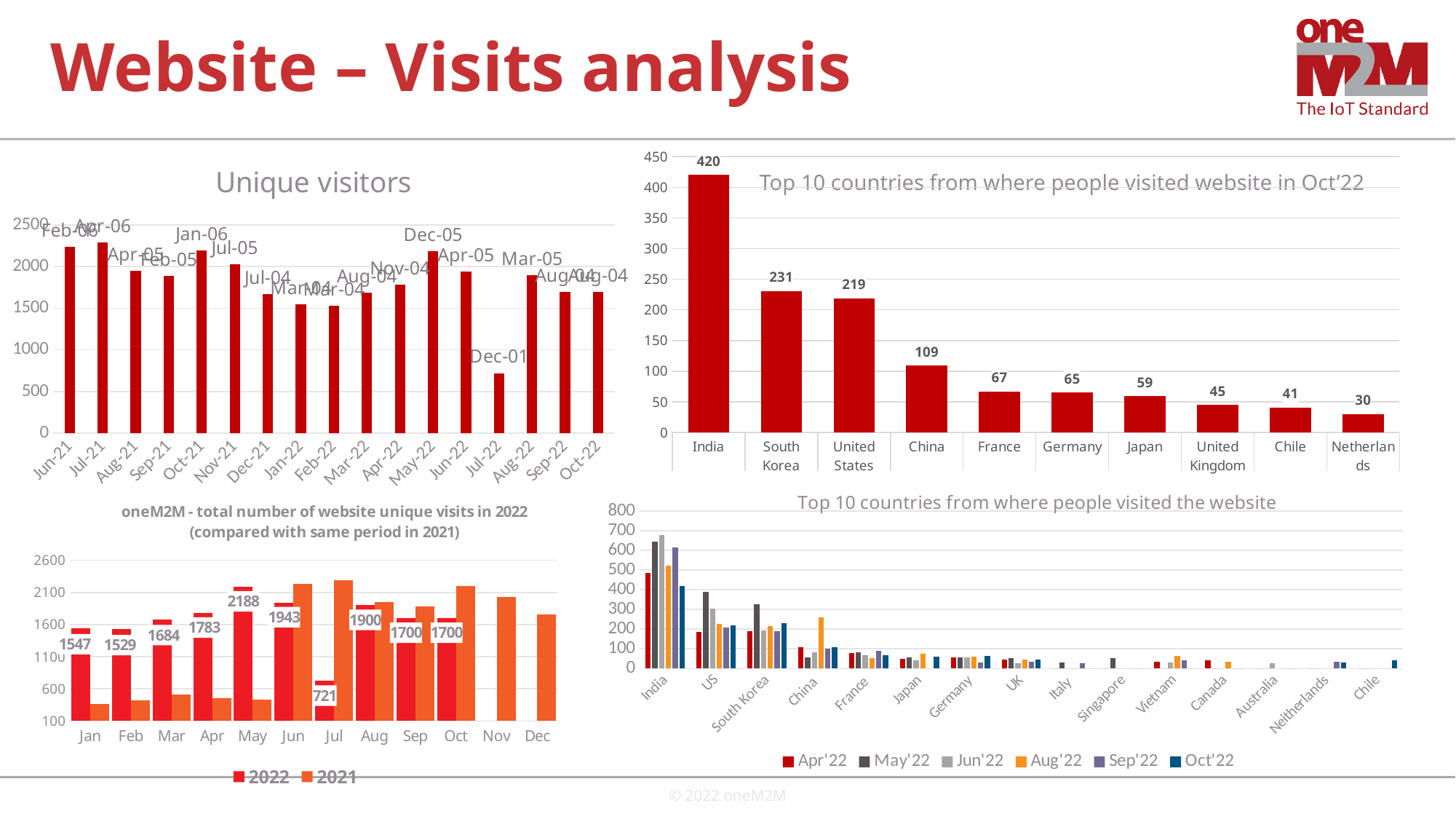
In the chart 'Top 10 countries from where people visited website in Oct'22', how many countries are shown? 10 In the bottom-left chart 'oneM2M - total number of website unique visits in 2022', what is the 2022 value for May? 2188 In the chart 'Top 10 countries from where people visited website in Oct'22', which country has the lowest value? Netherlands In the chart 'Top 10 countries from where people visited website in Oct'22', what is the value for India? 420 In the chart 'Top 10 countries from where people visited website in Oct'22', what is the difference between South Korea and United States? 12 In the 'Unique visitors' chart, is the value for Jul-22 greater or less than 1000? less In the bottom-left chart 'oneM2M - total number of website unique visits in 2022', how many series does the legend list? 2 What kind of chart is the 'Unique visitors' chart? bar chart In the bottom-right chart 'Top 10 countries from where people visited the website', how many series does the legend list? 6 In the chart 'Top 10 countries from where people visited website in Oct'22', what is the value for Germany? 65 In the bottom-left chart 'oneM2M - total number of website unique visits in 2022', what is the 2022 value for Jul? 721 In the bottom-left chart 'oneM2M - total number of website unique visits in 2022', which month has the highest 2022 value? May